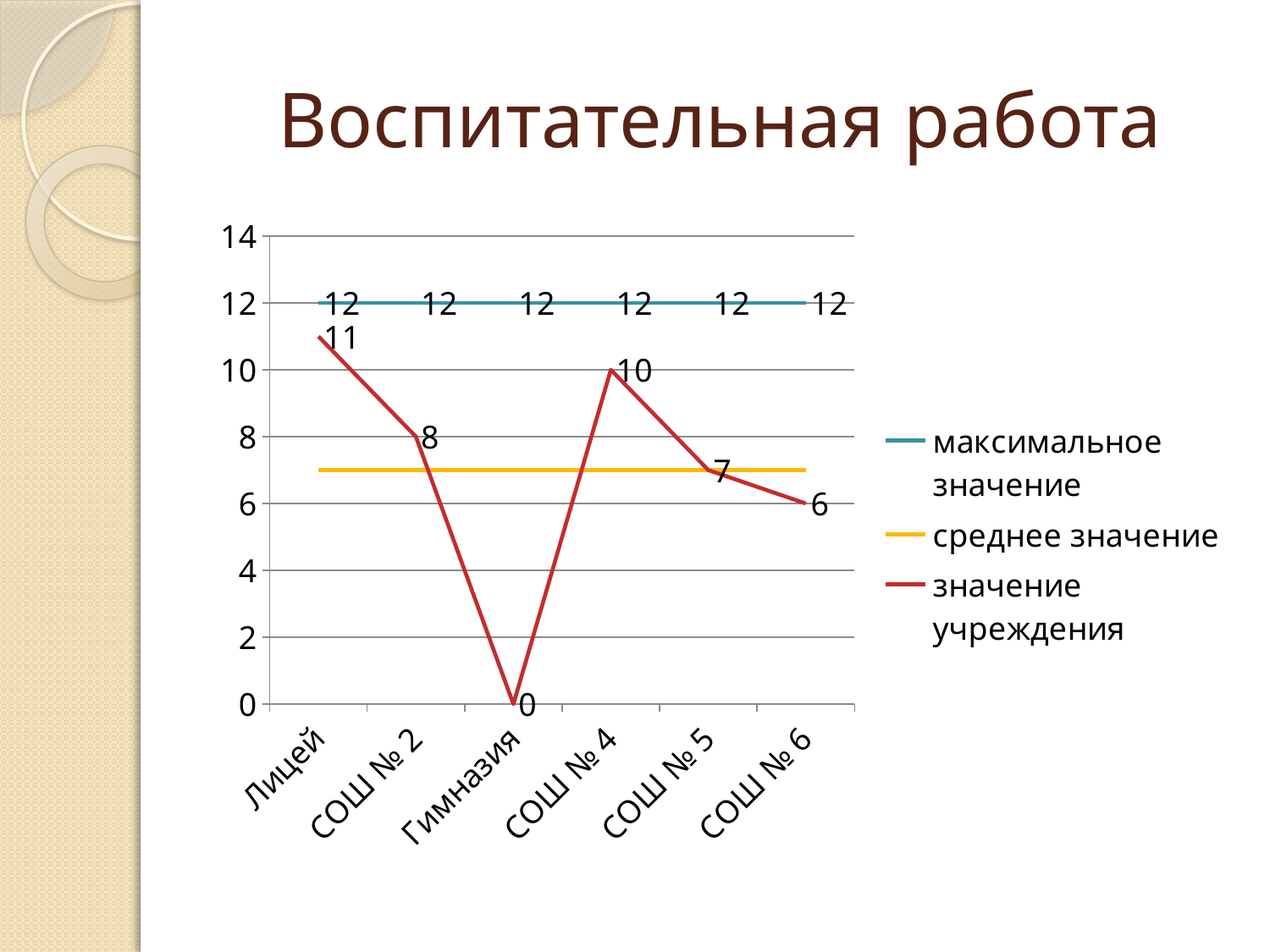
How many institutions are shown on the x axis? 6 What is the value of 'значение учреждения' for Гимназия? 0 Is the 'среднее значение' line greater or less than 8? less What kind of chart is shown on the slide? line chart What is the difference between the 'значение учреждения' for Лицей and for СОШ № 2? 3 What is the value of 'значение учреждения' for СОШ № 4? 10 Which institution has the lowest 'значение учреждения'? Гимназия Which institution has the highest 'значение учреждения'? Лицей How many series does the legend list? 3 Which has a larger 'значение учреждения', СОШ № 5 or СОШ № 6? СОШ № 5 What is the value of 'значение учреждения' for Лицей? 11 What is the value of 'максимальное значение' for СОШ № 6? 12